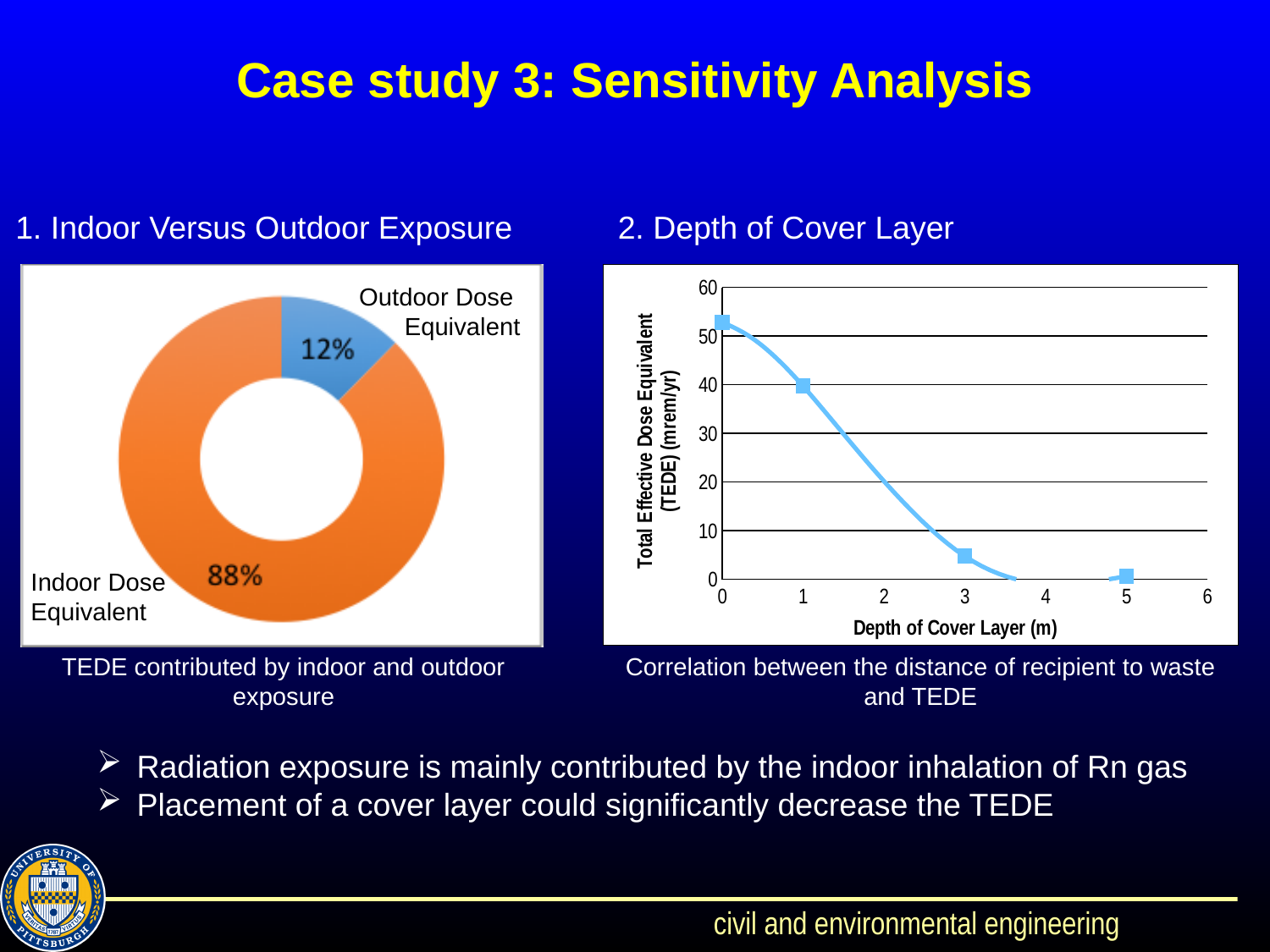
How many slices does the Indoor Versus Outdoor Exposure chart have? 2 In the Depth of Cover Layer chart, how many data points are plotted? 4 What kind of chart is the Indoor Versus Outdoor Exposure chart? Doughnut (pie) chart What is the x-axis label of the Depth of Cover Layer chart? Depth of Cover Layer (m) In the Depth of Cover Layer chart, at which plotted depth is the TEDE highest? 0 m In the Depth of Cover Layer chart, is the TEDE value at a depth of 3 m greater or less than 10? less In the Depth of Cover Layer chart, is the TEDE value at a depth of 0 m greater or less than 50? greater In the Depth of Cover Layer chart, does the TEDE rise or fall as the depth of the cover layer increases? Fall In the Indoor Versus Outdoor Exposure chart, what share of the TEDE is the Indoor Dose Equivalent? 88% In the Indoor Versus Outdoor Exposure chart, what share of the TEDE is the Outdoor Dose Equivalent? 12% In the Indoor Versus Outdoor Exposure chart, what is the difference in percentage points between the Indoor and Outdoor Dose Equivalent shares? 76 In the Indoor Versus Outdoor Exposure chart, which slice is larger, Indoor Dose Equivalent or Outdoor Dose Equivalent? Indoor Dose Equivalent